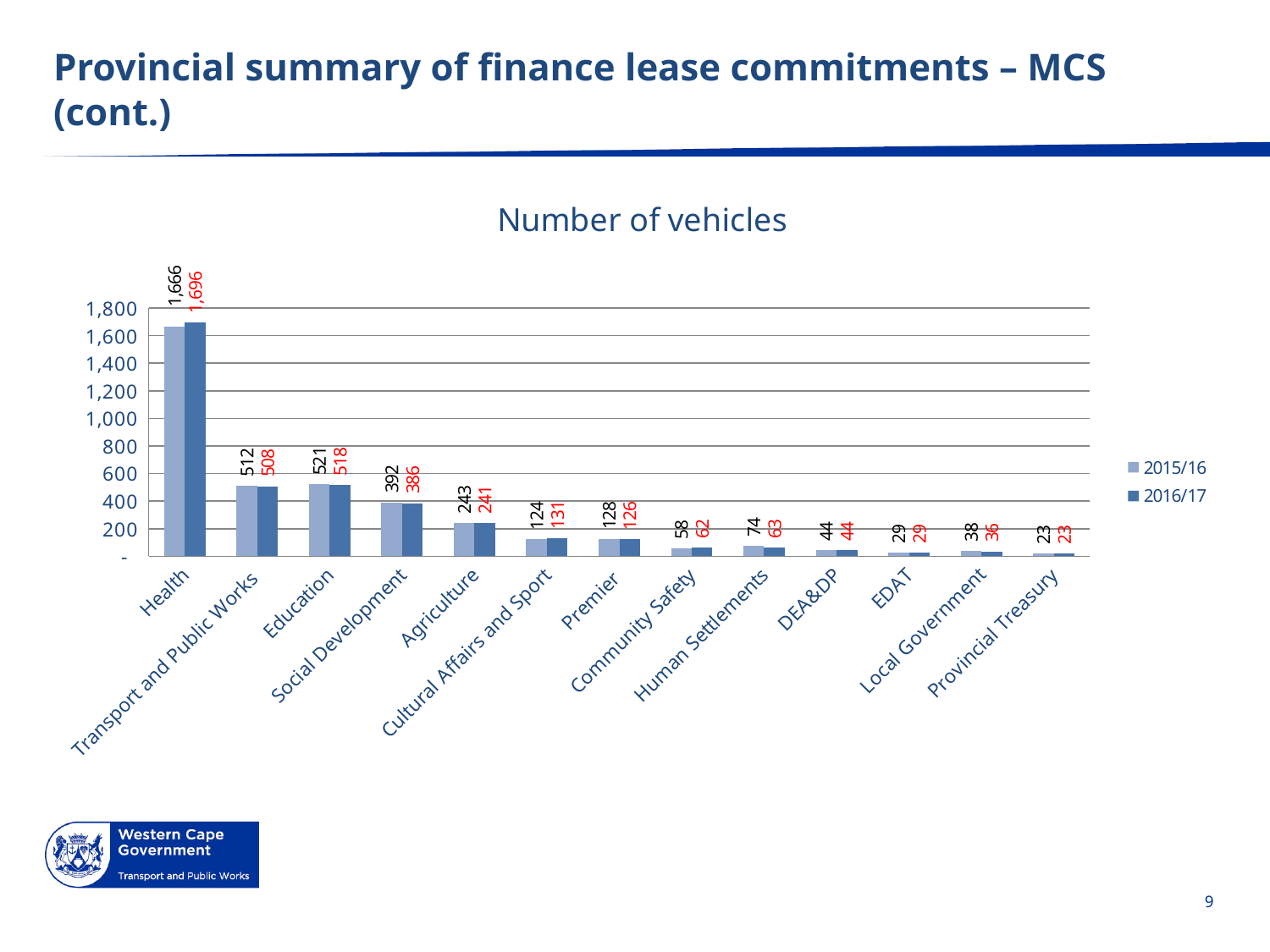
What is the number of vehicles for Health in 2016/17? 1,696 What kind of chart is shown on the slide? Bar chart Which category has the lowest number of vehicles in 2016/17? Provincial Treasury Which category has the highest number of vehicles in 2015/16? Health What is the title of the chart? Number of vehicles What is the number of vehicles for Cultural Affairs and Sport in 2016/17? 131 Which is larger for Human Settlements: the 2015/16 value or the 2016/17 value? 2015/16 Is the 2015/16 value for Social Development greater or less than 400? less How many categories are shown on the x axis? 13 What is the difference between the 2016/17 and 2015/16 values for Health? 30 What is the number of vehicles for Education in 2015/16? 521 How many series does the legend list? 2